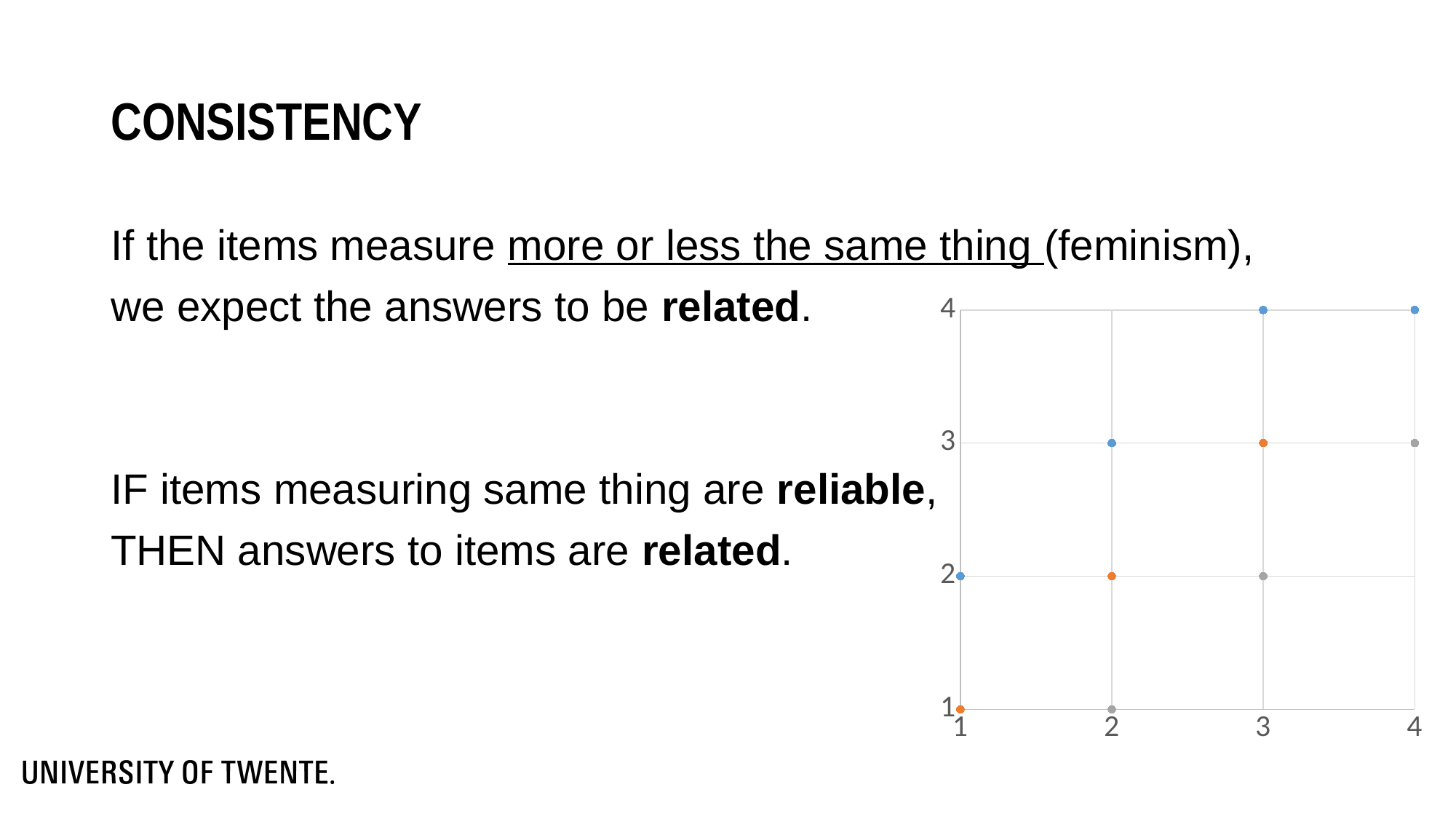
Which is larger at x = 2: the y value of the blue point or the y value of the grey point? blue point What is the y value of the grey point at x = 4? 3 What is the highest value shown on the chart's y axis? 4 What is the y value of the blue point at x = 1? 2 What is the lowest y value of any point in the chart? 1 What is the y value of the blue point at x = 4? 4 What kind of chart is shown on the slide? scatter chart How many different point colours appear in the chart? 3 What is the difference between the y value of the blue point and the grey point at x = 3? 2 What is the y value of the orange point at x = 3? 3 Do the plotted points generally rise or fall as x increases? rise